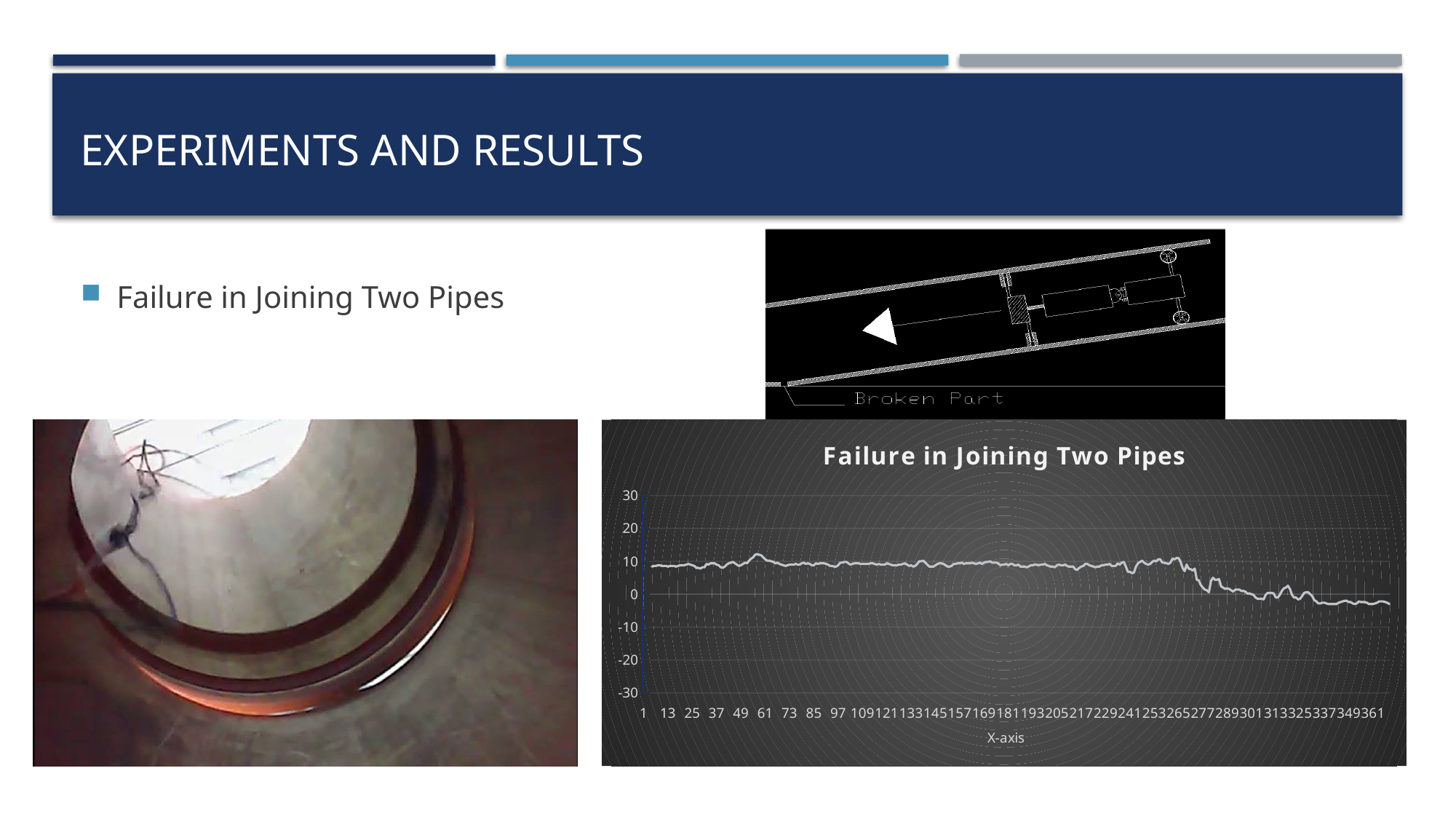
What kind of chart is shown on the slide? line chart Which is larger, the value at x = 61 or the value at x = 361? x = 61 Does the line ever go above 20 on the vertical axis? no Overall, do the plotted values rise or fall from the left to the right of the chart? fall Is the value at x = 361 greater or less than 10? less What is the title of the chart? Failure in Joining Two Pipes Is the value at x = 1 greater or less than 0? greater